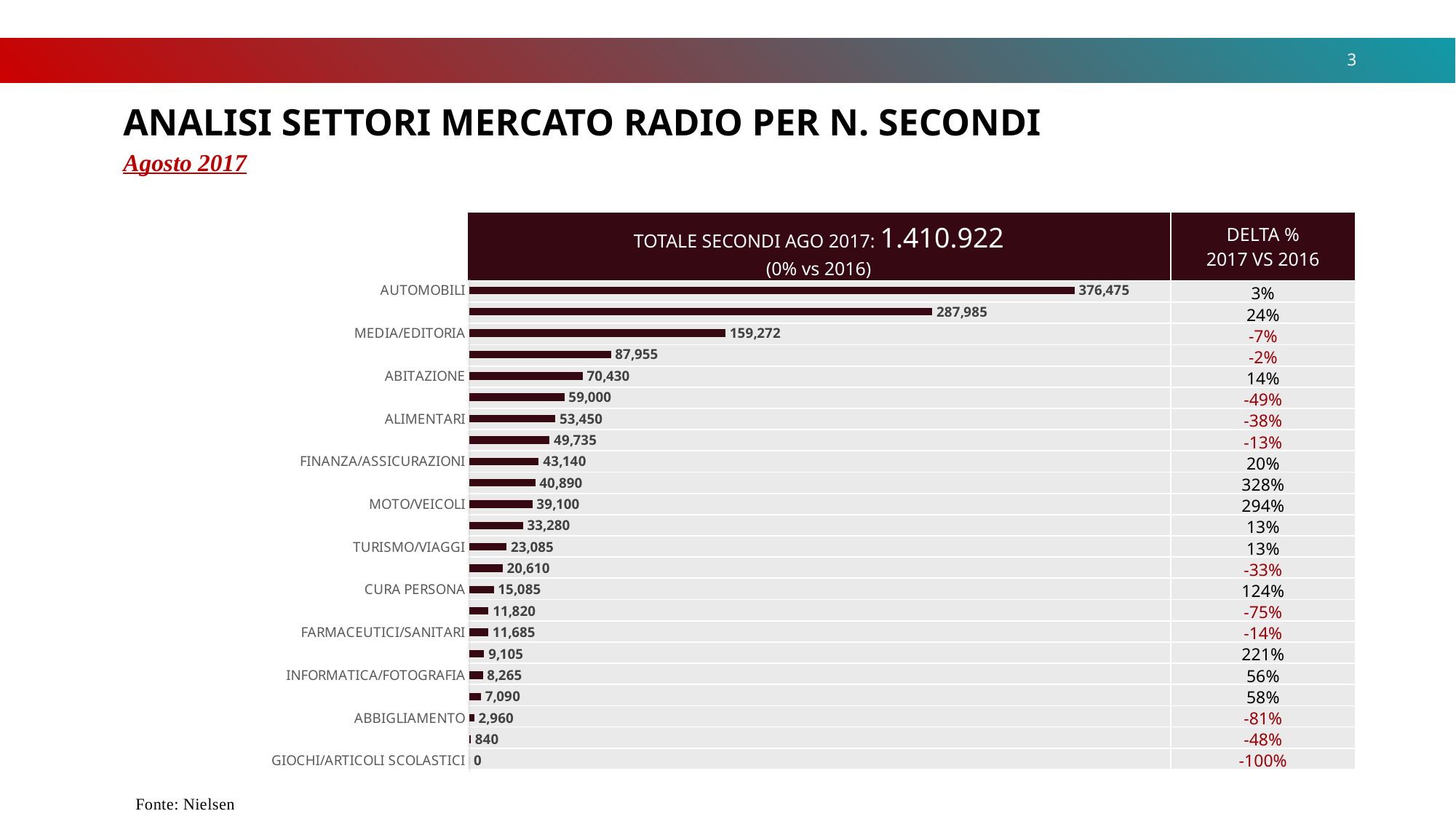
What total number of seconds for August 2017 is shown in the chart header? 1.410.922 Which labeled category has the highest value? AUTOMOBILI What is the value for ABITAZIONE? 70,430 What is the difference between the values for AUTOMOBILI and MEDIA/EDITORIA? 217,203 What kind of chart is shown on the slide? bar chart Which is larger, the value for ALIMENTARI or the value for FINANZA/ASSICURAZIONI? ALIMENTARI What is the value for GIOCHI/ARTICOLI SCOLASTICI? 0 Which labeled category has the lowest value? GIOCHI/ARTICOLI SCOLASTICI How many bars are plotted in the chart? 23 What is the value for MEDIA/EDITORIA? 159,272 What is the value for TURISMO/VIAGGI? 23,085 What is the value for AUTOMOBILI? 376,475